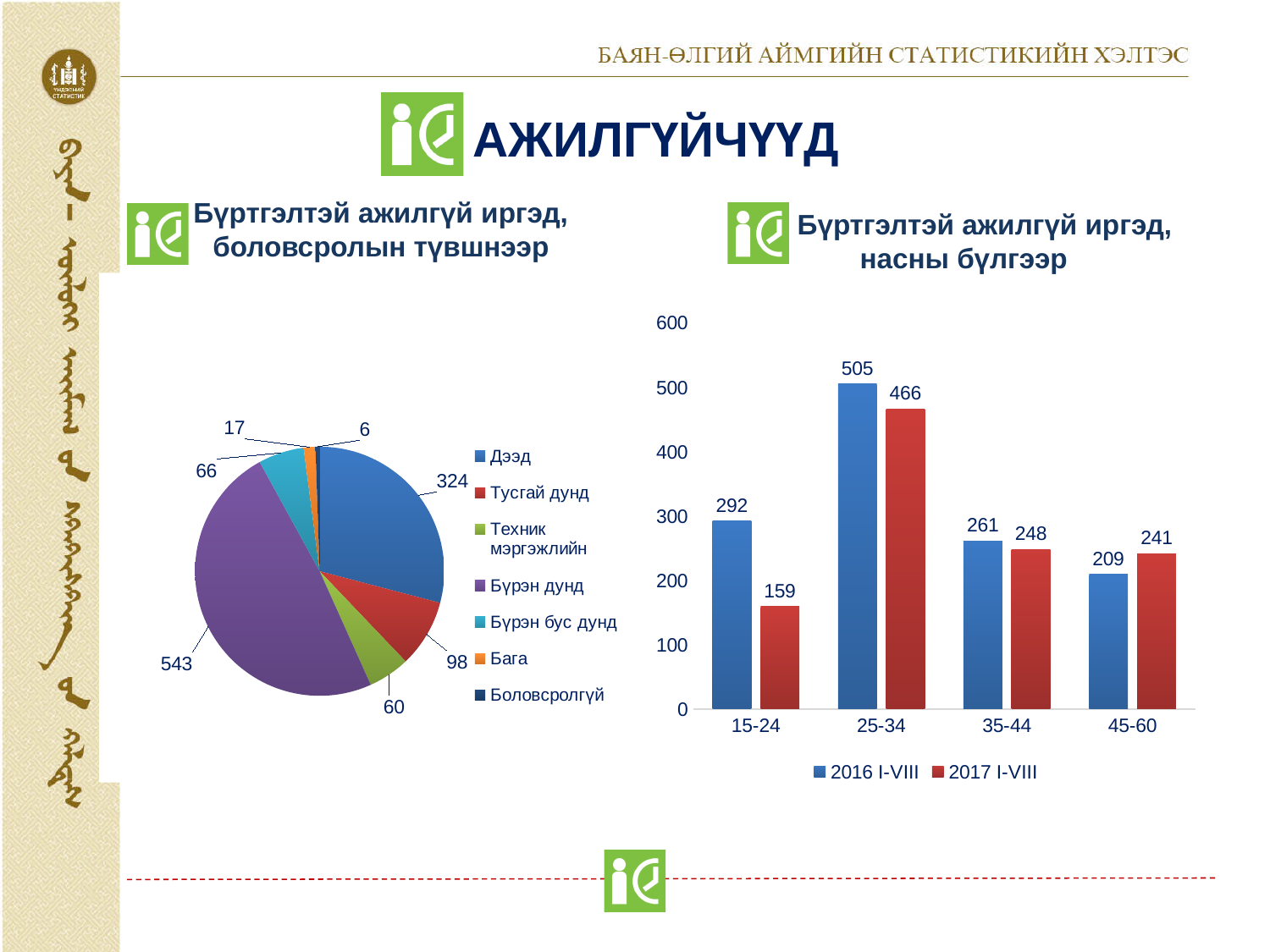
In the bar chart on the right, what is the value for 25-34 in 2016 I-VIII? 505 How many categories does the legend of the pie chart on the left list? 7 In the bar chart on the right, what is the value for 15-24 in 2017 I-VIII? 159 In the pie chart on the left, which category has the largest value? Бүрэн дунд In the bar chart on the right, which age group has the highest value for 2017 I-VIII? 25-34 In the pie chart on the left, what is the difference between Дээд and Тусгай дунд? 226 In the bar chart on the right, which is larger for 45-60: 2016 I-VIII or 2017 I-VIII? 2017 I-VIII In the pie chart on the left, what is the value for Бүрэн дунд? 543 What type of chart is the chart on the left? Pie chart In the bar chart on the right, what is the difference between 2016 I-VIII and 2017 I-VIII for 15-24? 133 How many series does the legend of the bar chart on the right list? 2 In the pie chart on the left, which category has the smallest value? Боловсролгүй